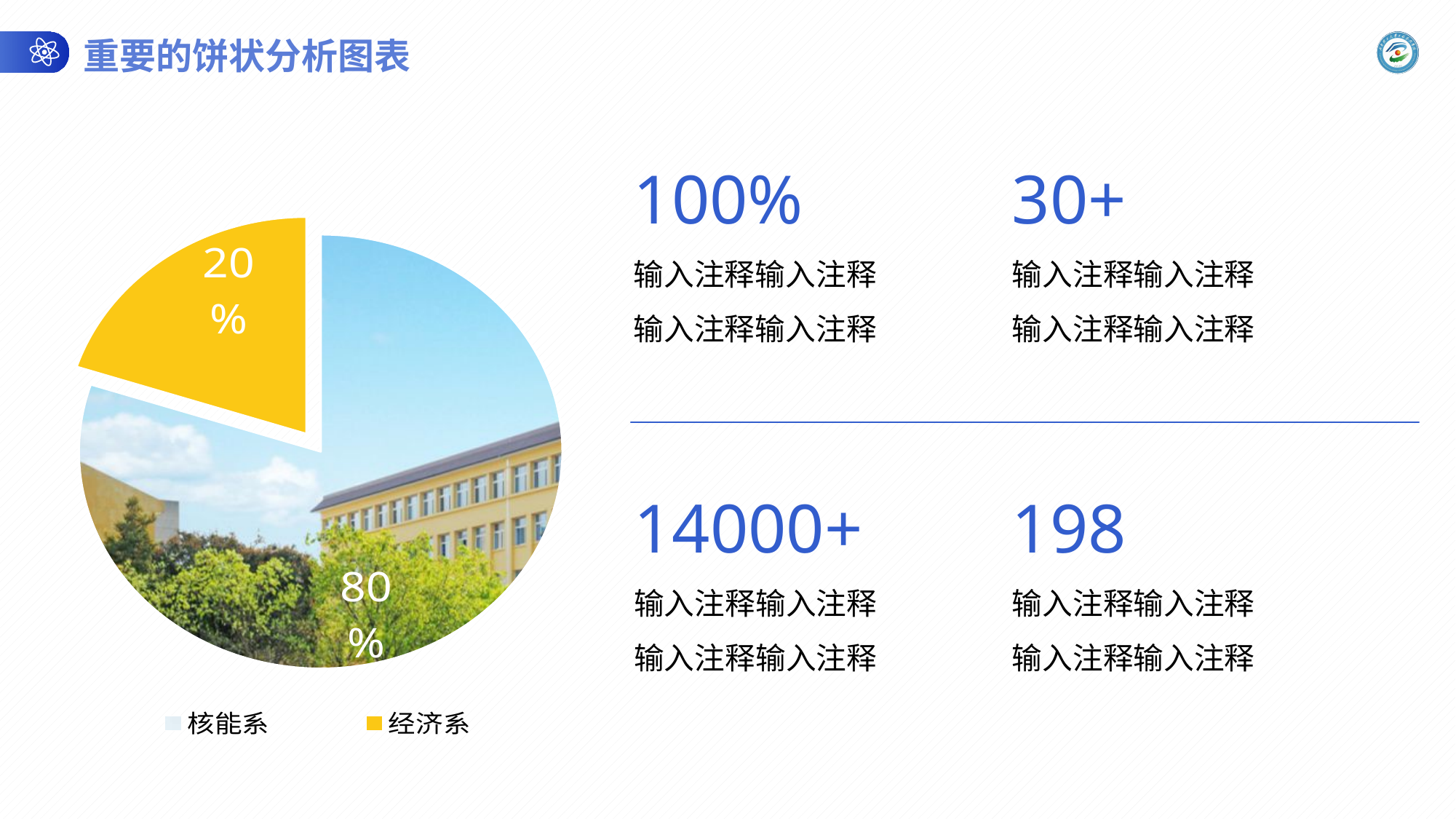
What share of the pie does 核能系 represent? 80% How many slices does the pie chart have? 2 What colour is the 经济系 slice in the pie chart? yellow What share of the pie does 经济系 represent? 20% Which is larger, the 核能系 slice or the 经济系 slice? 核能系 Which slice of the pie chart is the largest? 核能系 What is the difference in percentage points between the 核能系 slice and the 经济系 slice? 60 What kind of chart is shown on the slide? pie chart Which slice of the pie chart is the smallest? 经济系 How many entries does the legend of the pie chart list? 2 Which slice of the pie chart is pulled out (exploded) from the rest? 经济系